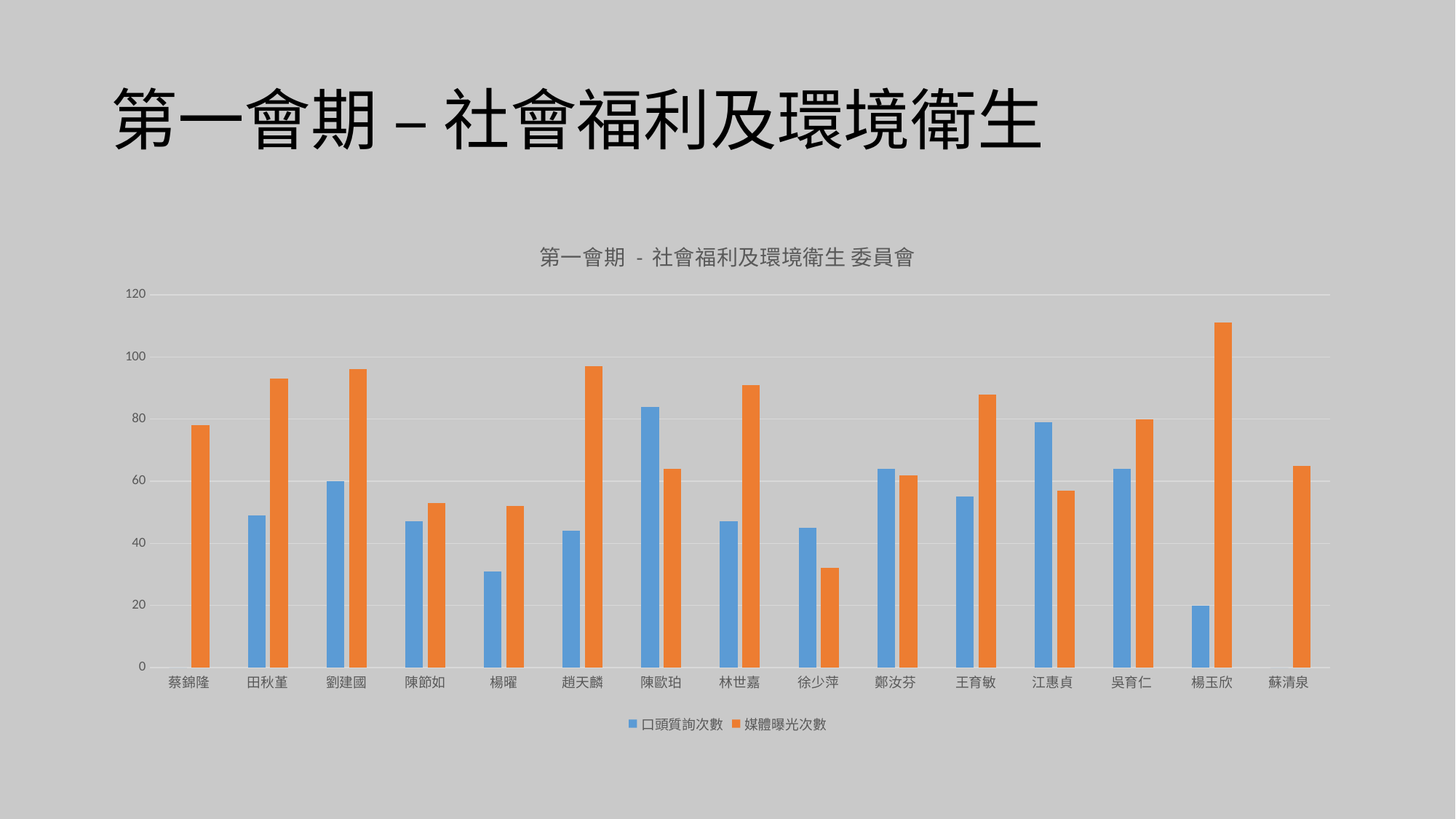
For 田秋堇, which is larger: 口頭質詢次數 or 媒體曝光次數? 媒體曝光次數 How many series does the legend list? 2 What kind of chart is shown on the slide? bar chart For 陳歐珀, which is larger: 口頭質詢次數 or 媒體曝光次數? 口頭質詢次數 Which legislator has the highest 口頭質詢次數? 陳歐珀 Is the 媒體曝光次數 value for 楊玉欣 greater or less than 100? greater Is the 口頭質詢次數 value for 楊曜 greater or less than 40? less Which legislator has the highest 媒體曝光次數? 楊玉欣 Which colour represents 媒體曝光次數 in the chart? orange Which legislator has the lowest 媒體曝光次數? 徐少萍 Is the 媒體曝光次數 value for 趙天麟 greater or less than 80? greater How many legislators (categories) are shown on the x axis? 15